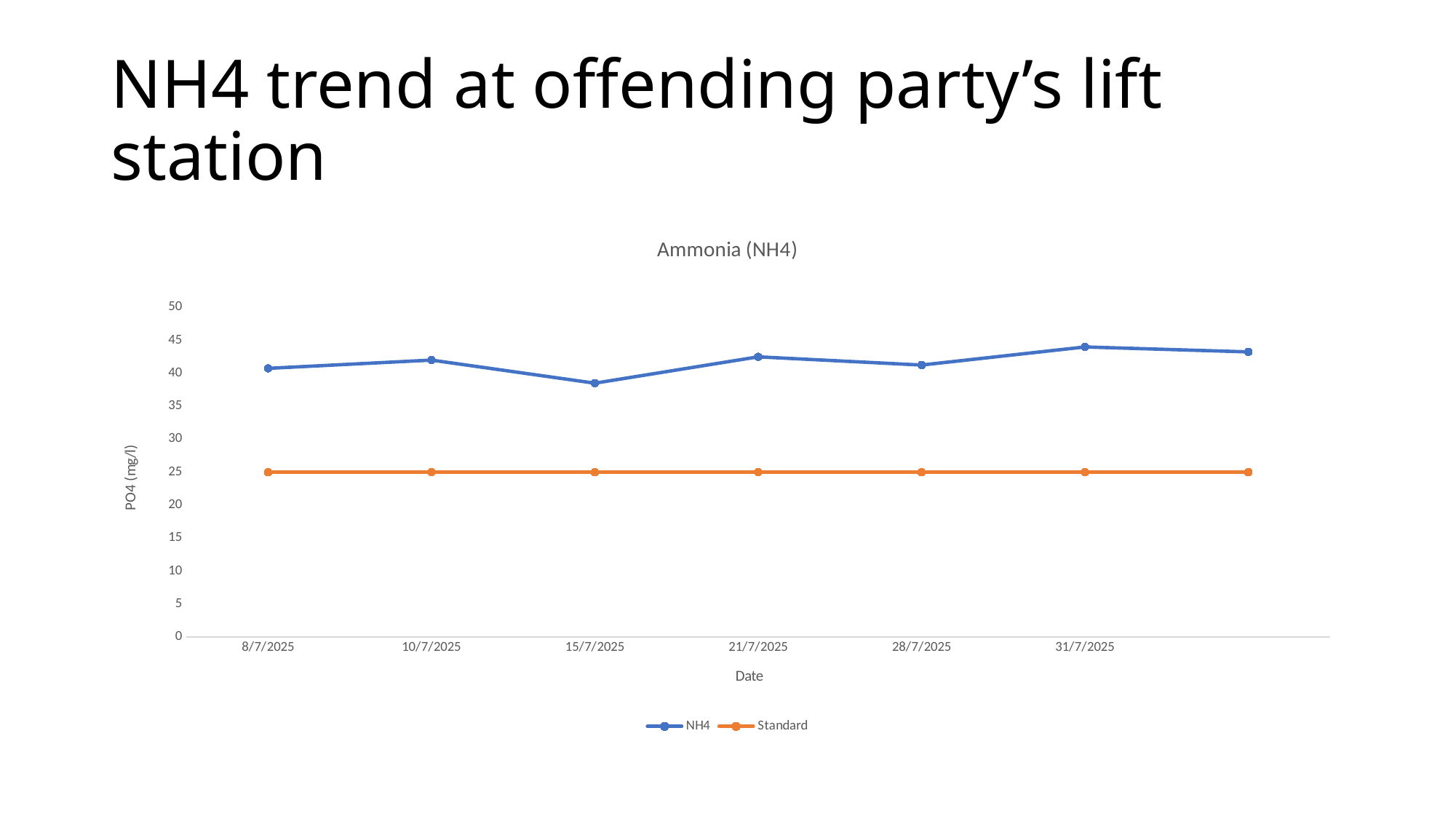
Is the NH4 value on 31/7/2025 greater or less than 40? greater What is the label on the vertical axis of the chart? PO4 (mg/l) Does the Standard line rise, fall or stay flat across the dates? stay flat What is the value of the Standard series on 8/7/2025? 25 Is the NH4 value on 8/7/2025 greater or less than 35? greater Which series has the higher value on 21/7/2025, NH4 or Standard? NH4 Is the NH4 value on 15/7/2025 greater or less than 40? less What kind of chart is shown on the slide? line chart Which date has the higher NH4 value, 10/7/2025 or 15/7/2025? 10/7/2025 On which date is the NH4 value lowest? 15/7/2025 How many series does the legend list? 2 Does the NH4 line rise or fall from 10/7/2025 to 15/7/2025? fall